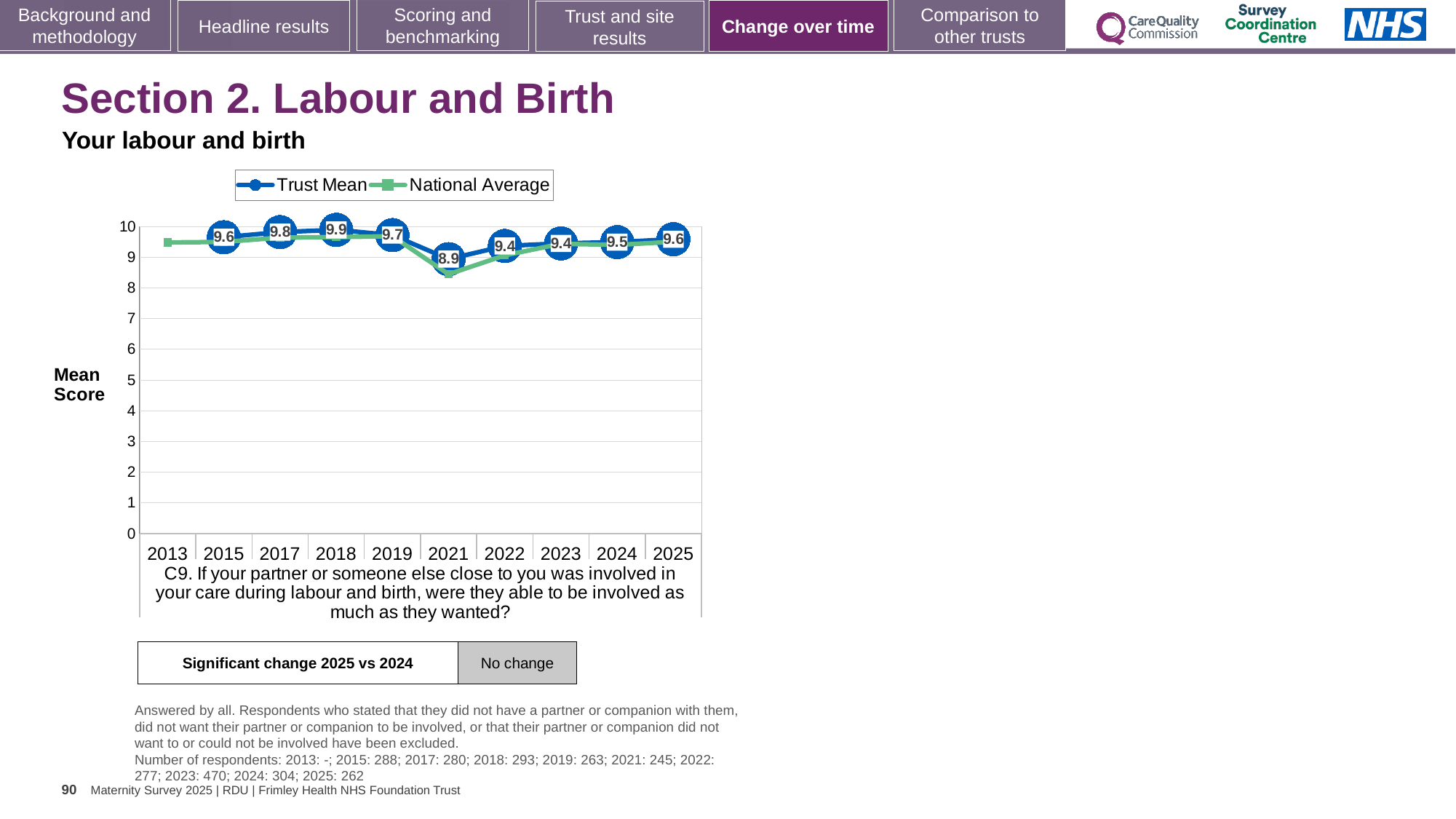
How many series does the legend list? 2 What is the difference between the Trust Mean in 2018 and in 2021? 1.0 How many years are shown on the x axis? 10 What is the Trust Mean score for 2018? 9.9 Does the Trust Mean rise or fall from 2021 to 2025? rise Which is larger, the Trust Mean in 2017 or in 2022? 2017 What kind of chart is shown on the slide? line chart Is the National Average value for 2021 greater or less than 9? less In which year is the Trust Mean lowest? 2021 What is the Trust Mean score for 2021? 8.9 In which year is the Trust Mean highest? 2018 What is the Trust Mean score for 2025? 9.6